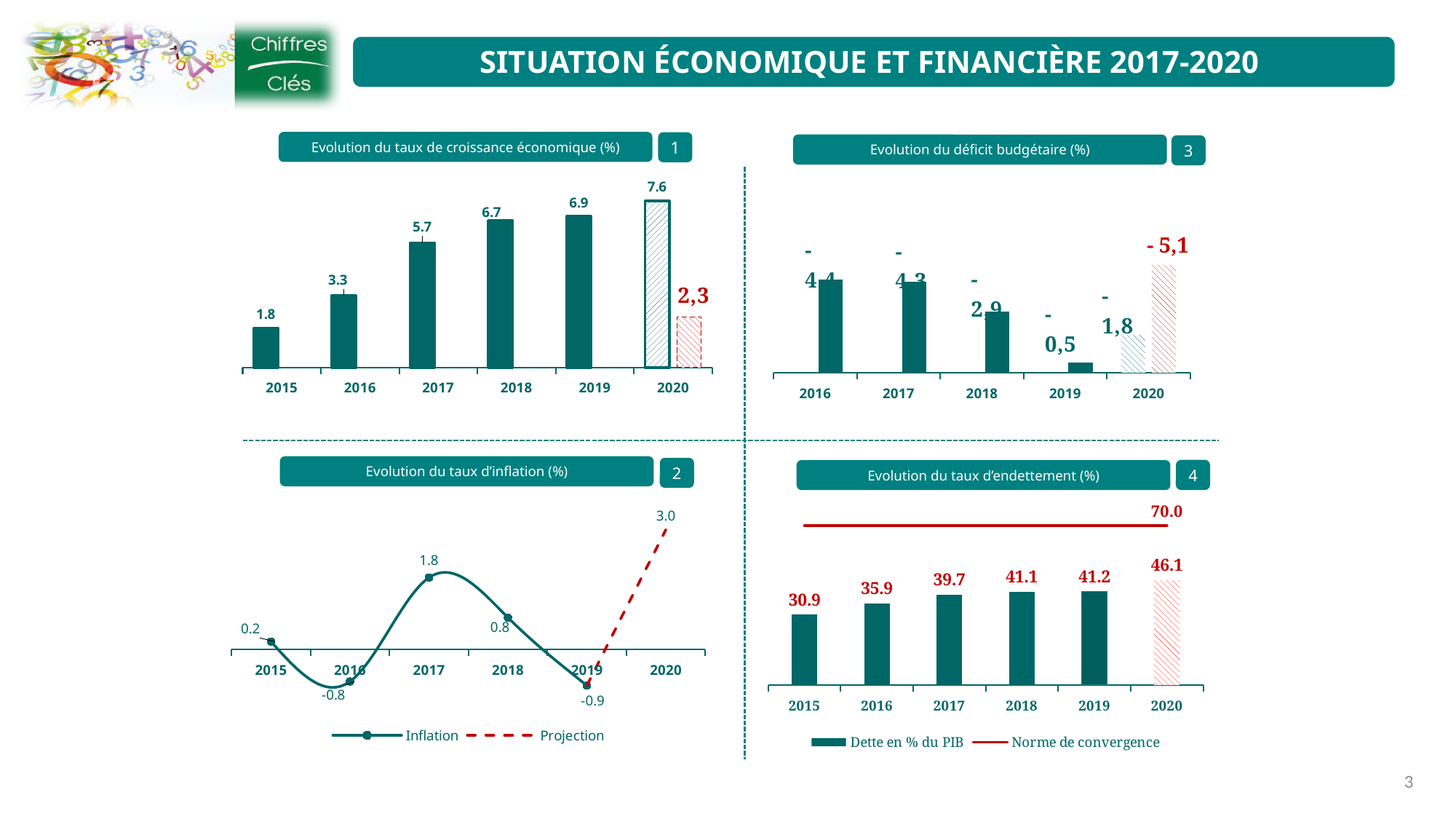
What kind of chart is 'Evolution du taux de croissance économique (%)'? bar chart In the chart 'Evolution du taux de croissance économique (%)', what is the value for 2015? 1.8 In the chart 'Evolution du taux d'inflation (%)', what is the inflation value for 2017? 1.8 In the chart 'Evolution du taux d'inflation (%)', which year has the lowest inflation value? 2019 In the chart 'Evolution du taux d'endettement (%)', what is the value of the 'Norme de convergence' line? 70.0 In the chart 'Evolution du taux de croissance économique (%)', do the solid bars rise or fall from 2015 to 2019? rise In the chart 'Evolution du taux de croissance économique (%)', what is the value for 2017? 5.7 In the chart 'Evolution du taux de croissance économique (%)', what is the difference between the 2019 value and the 2018 value? 0.2 In the chart 'Evolution du déficit budgétaire (%)', what is the value for 2019? -0,5 In the chart 'Evolution du taux d'endettement (%)', what is the value of 'Dette en % du PIB' for 2016? 35.9 In the chart 'Evolution du taux d'inflation (%)', what is the projected value for 2020? 3.0 How many series does the legend of the chart 'Evolution du taux d'inflation (%)' list? 2